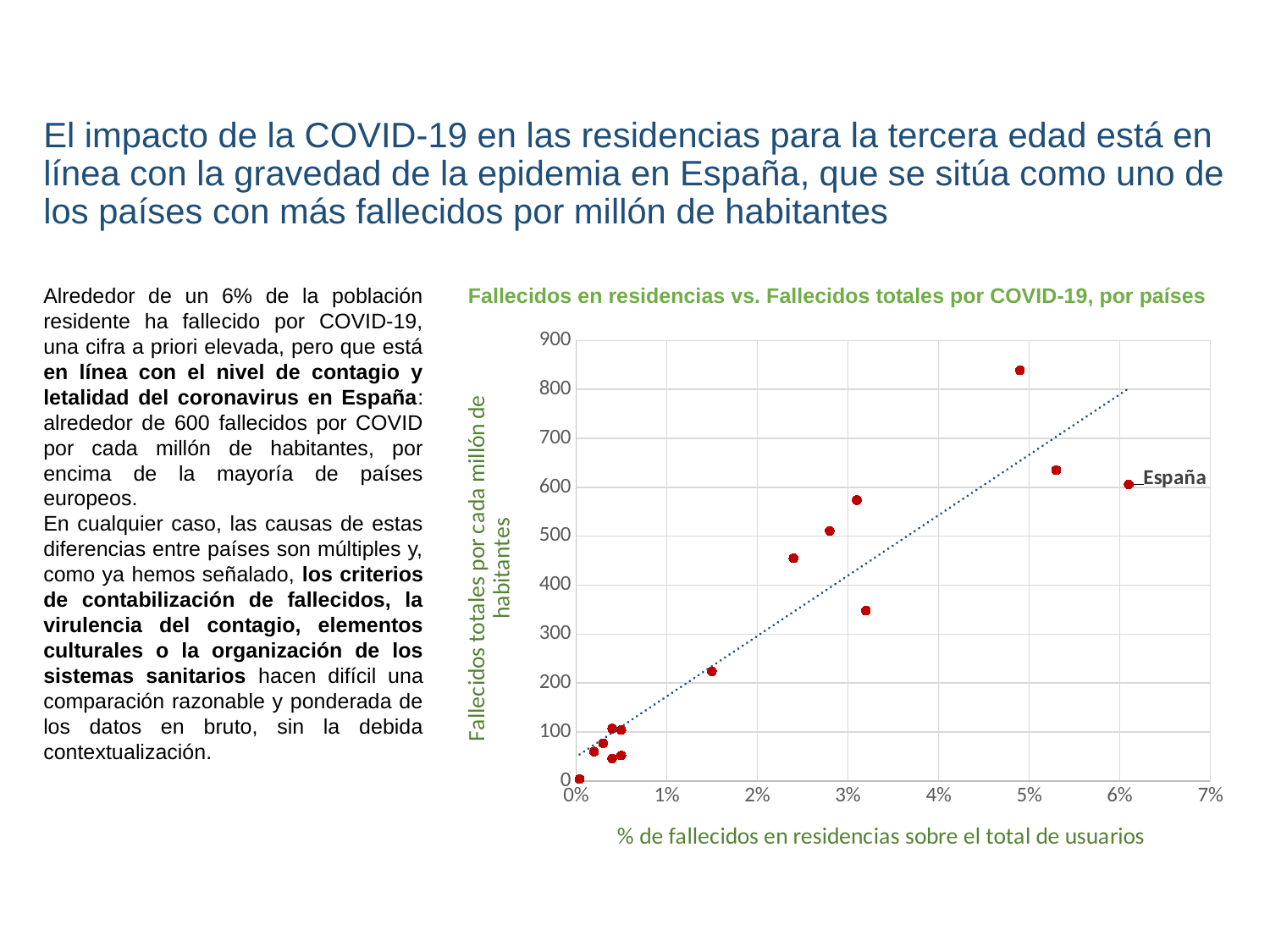
Do the values of fallecidos totales generally rise or fall as the % de fallecidos en residencias increases? rise Which country is labelled on the chart? España What is the title of the chart? Fallecidos en residencias vs. Fallecidos totales por COVID-19, por países Is the value of fallecidos totales por cada millón de habitantes for España greater or less than 500? greater What kind of chart is shown on the slide? Scatter chart What is the maximum value shown on the vertical axis? 900 Is the point for España the highest point on the vertical axis? No Is the highest point on the vertical axis greater or less than 800? greater Is the value of fallecidos totales por cada millón de habitantes for España greater or less than 700? less